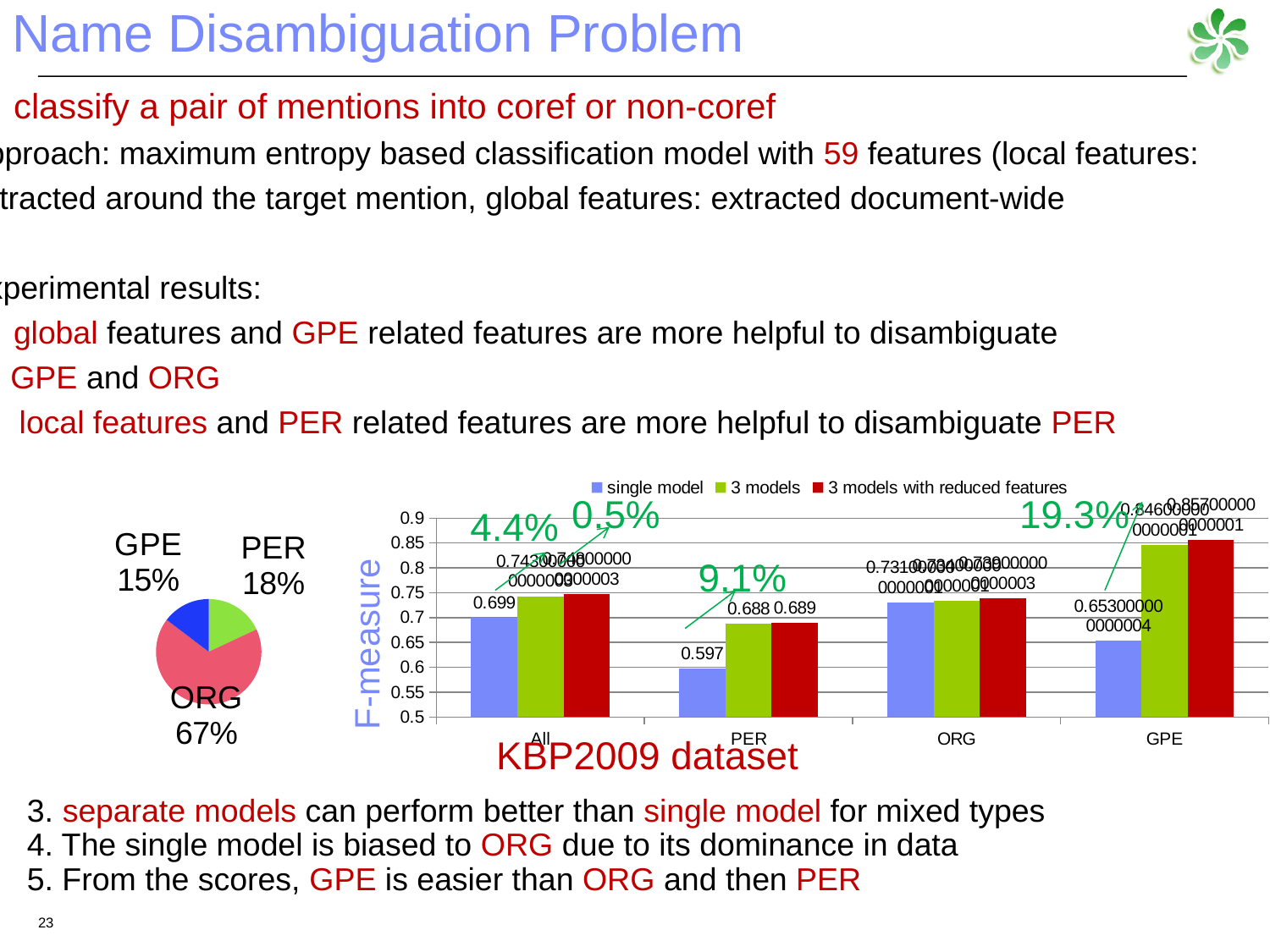
How many series does the bar chart's legend list? 3 In the pie chart, which category has the largest slice? ORG In the pie chart, which category has the smallest slice? GPE How many slices does the pie chart have? 3 In the pie chart, what share does GPE have? 15% In the bar chart, what is the F-measure of 3 models for PER? 0.688 In the bar chart, what is the F-measure of the single model for All? 0.699 In the pie chart, what share does ORG have? 67% In the bar chart, is the single model value for GPE greater or less than 0.7? less In the bar chart, what is the difference between the 3 models with reduced features and the single model for PER? 0.092 In the bar chart, what is the F-measure of the single model for PER? 0.597 In the bar chart, which category has the lowest single model F-measure? PER